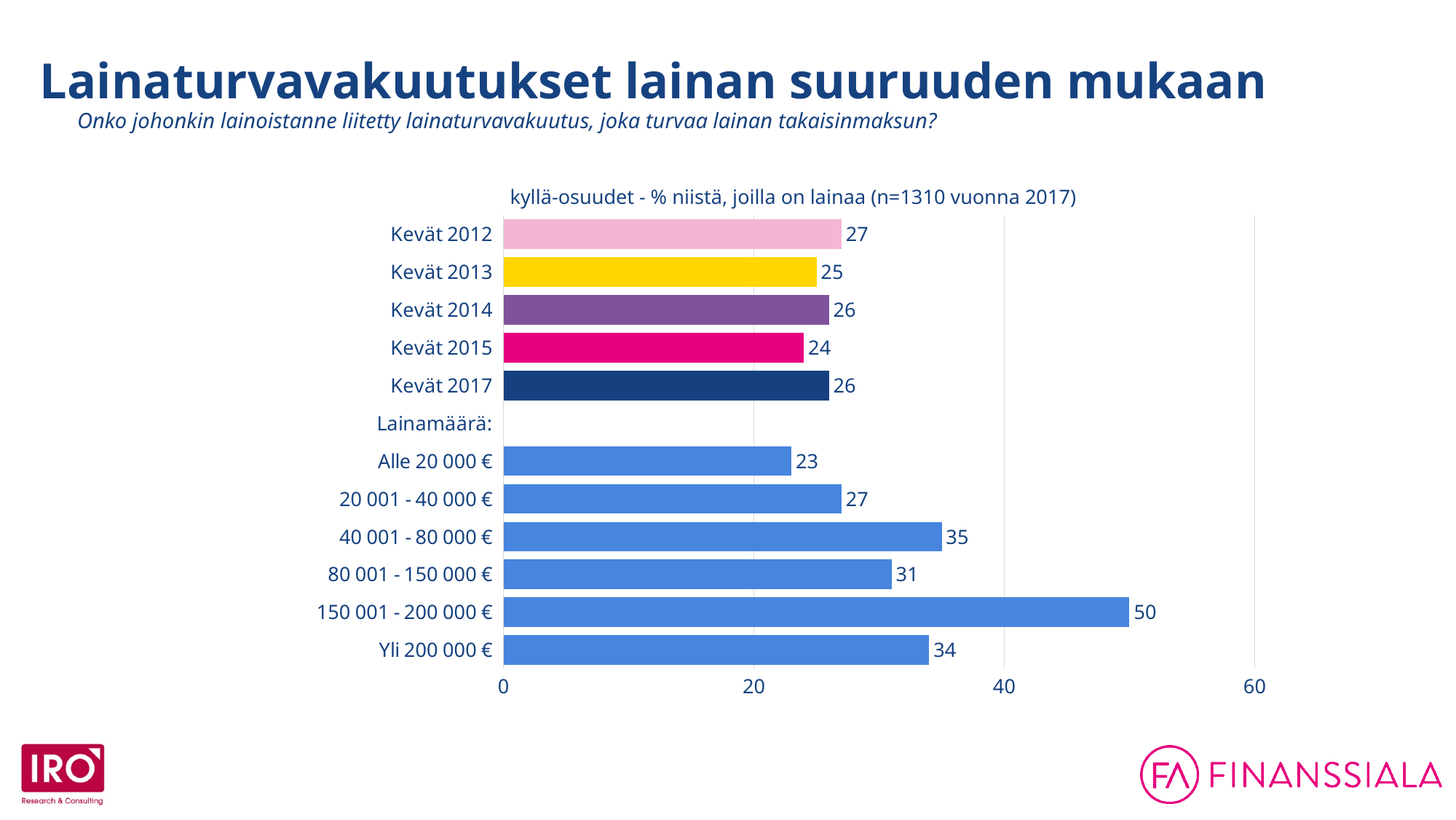
What is the chart's title? kyllä-osuudet - % niistä, joilla on lainaa (n=1310 vuonna 2017) What is the value for Kevät 2015? 24 How many loan amount categories are plotted under Lainamäärä? 6 What is the difference between the values for 150 001 - 200 000 € and Yli 200 000 €? 16 Is the value for 150 001 - 200 000 € greater or less than 40? greater What kind of chart is shown on the slide? Bar chart What is the difference between the values for Kevät 2012 and Kevät 2013? 2 What is the value for Kevät 2012? 27 What is the value for the 150 001 - 200 000 € loan amount category? 50 Which is larger, the value for 40 001 - 80 000 € or the value for 80 001 - 150 000 €? 40 001 - 80 000 € Which loan amount category has the highest value? 150 001 - 200 000 € Which loan amount category has the lowest value? Alle 20 000 €